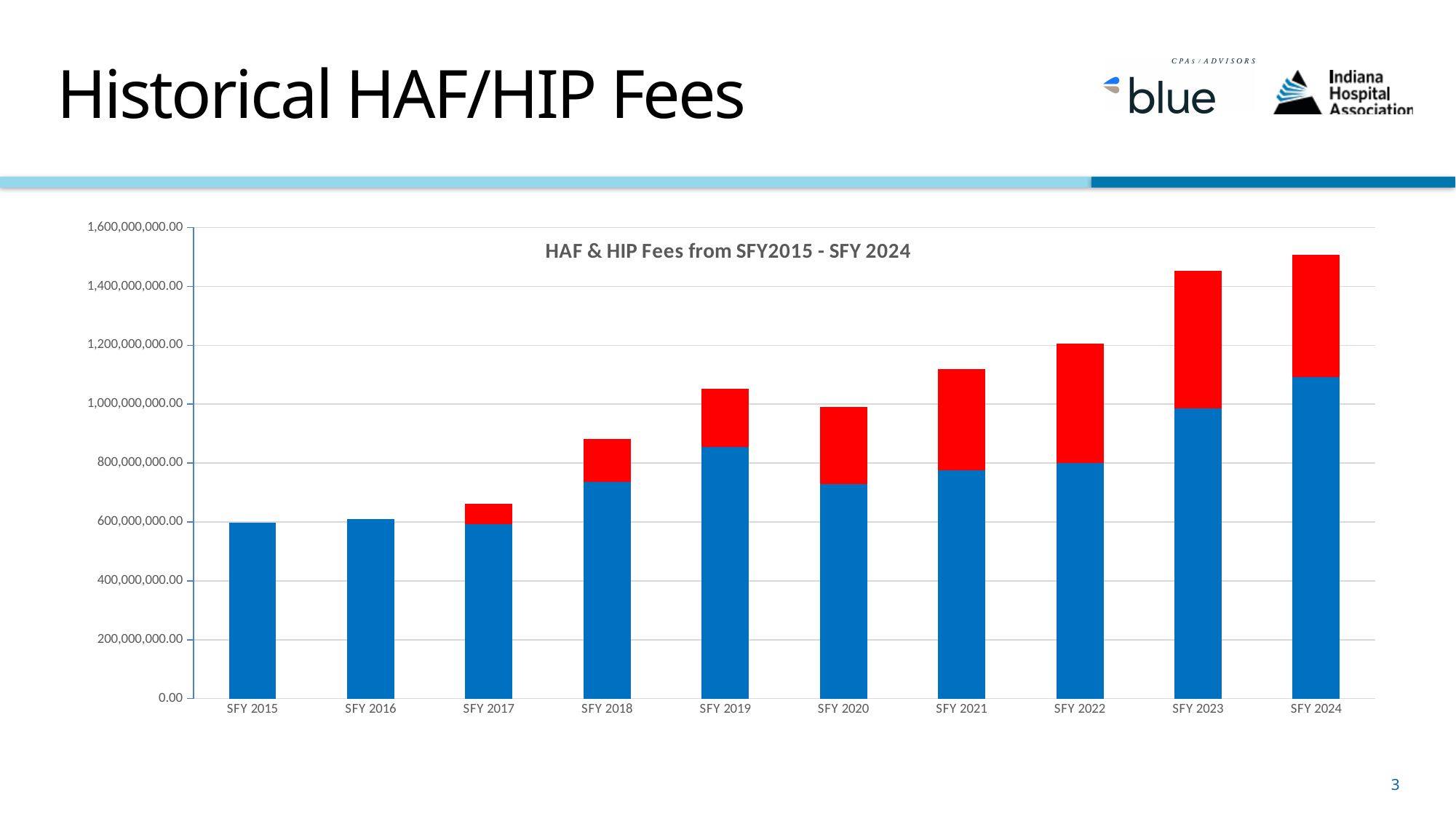
Do the total bars generally rise or fall from SFY 2015 to SFY 2024? Rise What is the title of the chart? HAF & HIP Fees from SFY2015 - SFY 2024 Is the total bar for SFY 2017 greater or less than 600,000,000.00? greater Which fiscal year has the highest total bar? SFY 2024 Is the total bar for SFY 2018 greater or less than 800,000,000.00? greater Which has the larger total bar, SFY 2022 or SFY 2023? SFY 2023 How many fiscal years (bars) are shown on the x axis? 10 Is the total bar for SFY 2021 greater or less than 1,000,000,000.00? greater Which has the larger total bar, SFY 2019 or SFY 2020? SFY 2019 How many colored segments make up each stacked bar from SFY 2017 onward? 2 What kind of chart is shown on the slide? Stacked bar chart